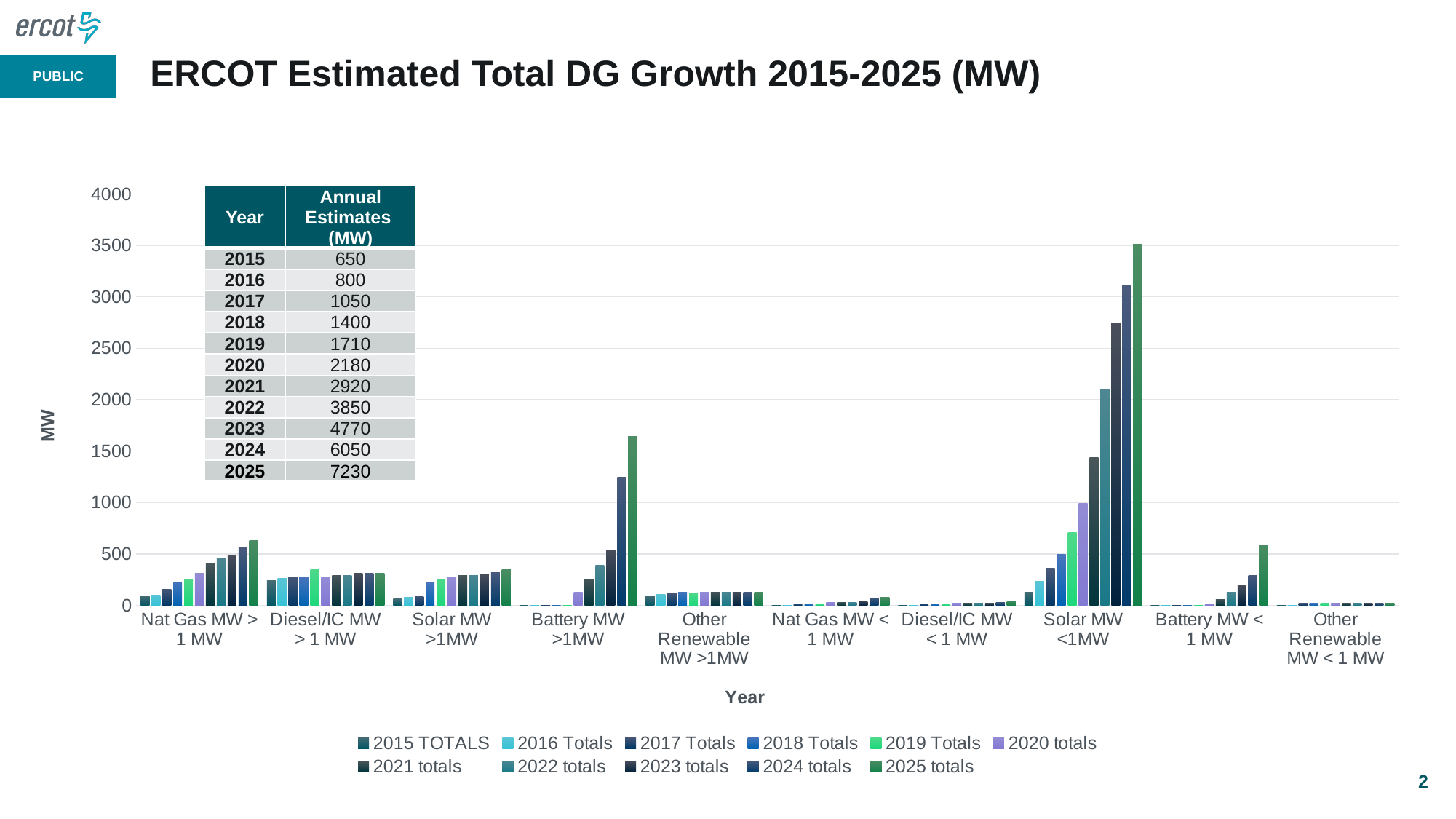
What kind of chart is shown on the slide? bar chart How many categories are shown along the x axis of the chart? 10 Is the 2025 totals value for Nat Gas MW > 1 MW greater or less than 1000? less Which category contains the tallest bar in the chart? Solar MW <1MW Is the 2025 totals value for Solar MW <1MW greater or less than 3000? greater What is the title of the chart's vertical axis? MW Do the bars for Solar MW <1MW rise or fall from the 2015 series to the 2025 series? rise For the 2025 totals series, which is larger: Nat Gas MW > 1 MW or Diesel/IC MW > 1 MW? Nat Gas MW > 1 MW How many series does the chart's legend list? 11 Is the 2025 totals value for Battery MW >1MW greater or less than 1500? greater For the 2025 totals series, which is larger: Solar MW <1MW or Battery MW >1MW? Solar MW <1MW